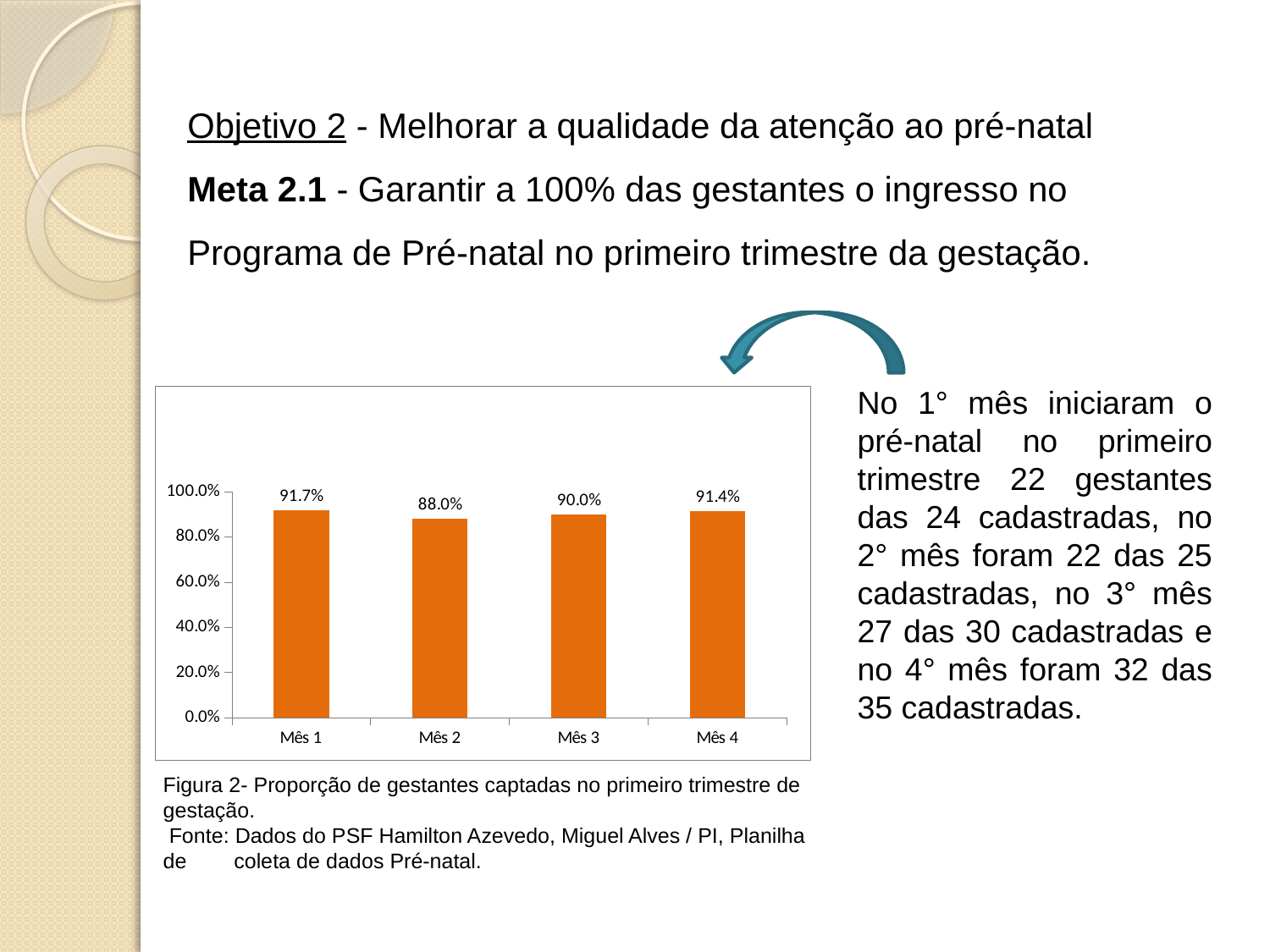
What is the difference between the values for Mês 1 and Mês 2? 3.7% What is the value for Mês 4? 91.4% What is the value for Mês 2? 88.0% Is the value for Mês 2 greater or less than 80.0%? greater How many months are shown on the x axis? 4 What is the value for Mês 1? 91.7% What colour are the bars in the chart? orange What is the value for Mês 3? 90.0% Which is larger, the value for Mês 3 or the value for Mês 4? Mês 4 Which month has the lowest value? Mês 2 What kind of chart is shown on the slide? bar chart Which month has the highest value? Mês 1